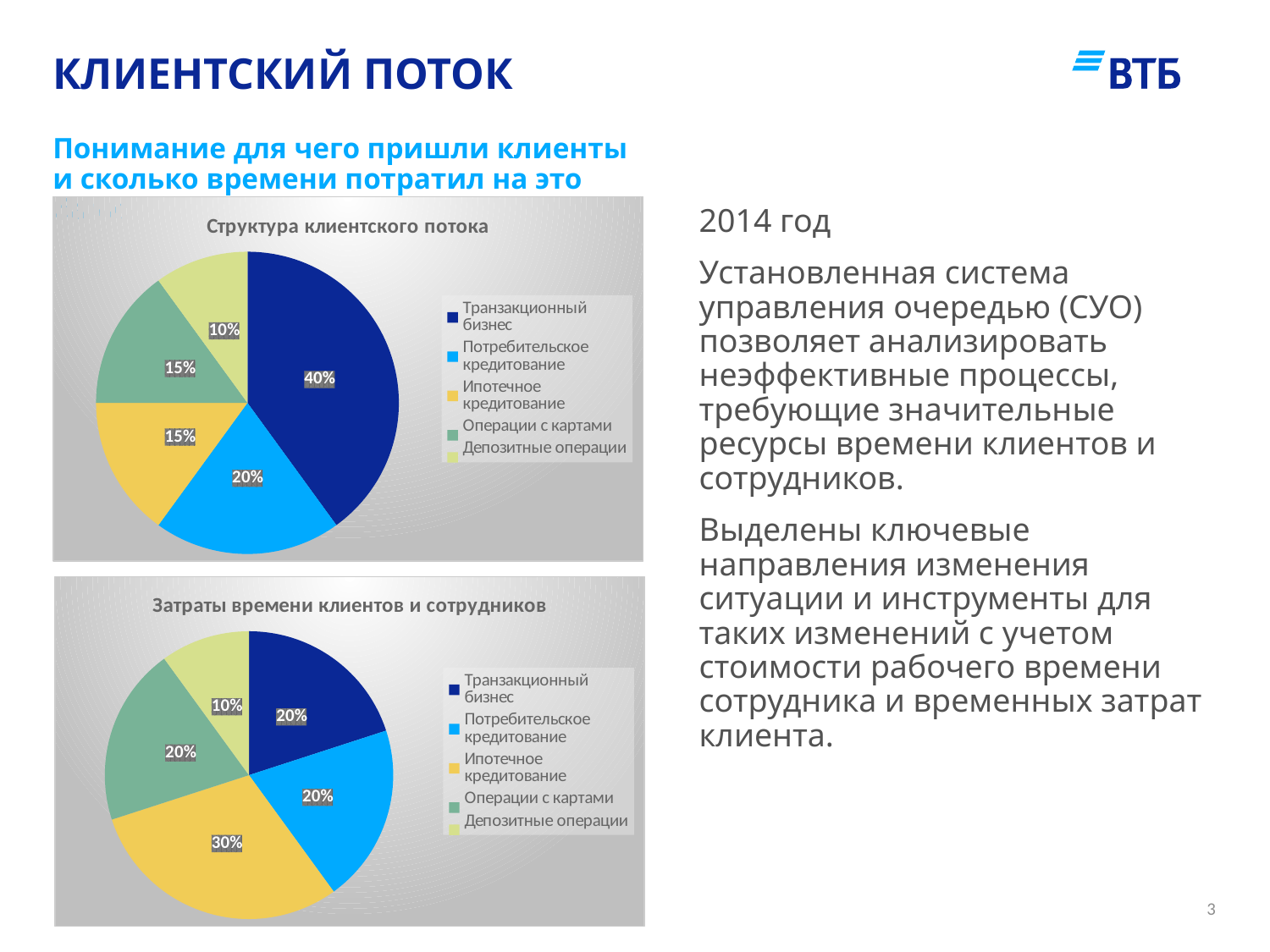
How many categories does the legend of the chart titled "Структура клиентского потока" list? 5 In the chart titled "Затраты времени клиентов и сотрудников", what share does "Ипотечное кредитование" have? 30% In the chart titled "Структура клиентского потока", what is the difference between the shares of "Транзакционный бизнес" and "Потребительское кредитование"? 20% In the chart titled "Структура клиентского потока", which category has the largest share? Транзакционный бизнес What is the title of the top chart on the slide? Структура клиентского потока In the chart titled "Затраты времени клиентов и сотрудников", which category has the smallest share? Депозитные операции In the chart titled "Структура клиентского потока", what share does "Депозитные операции" have? 10% In the chart titled "Структура клиентского потока", what share does "Транзакционный бизнес" have? 40% In the chart titled "Затраты времени клиентов и сотрудников", which is larger: the share of "Ипотечное кредитование" or the share of "Операции с картами"? Ипотечное кредитование In the chart titled "Затраты времени клиентов и сотрудников", which category has the largest share? Ипотечное кредитование In the chart titled "Структура клиентского потока", which category has the smallest share? Депозитные операции What kind of chart is the chart titled "Затраты времени клиентов и сотрудников"? Pie chart